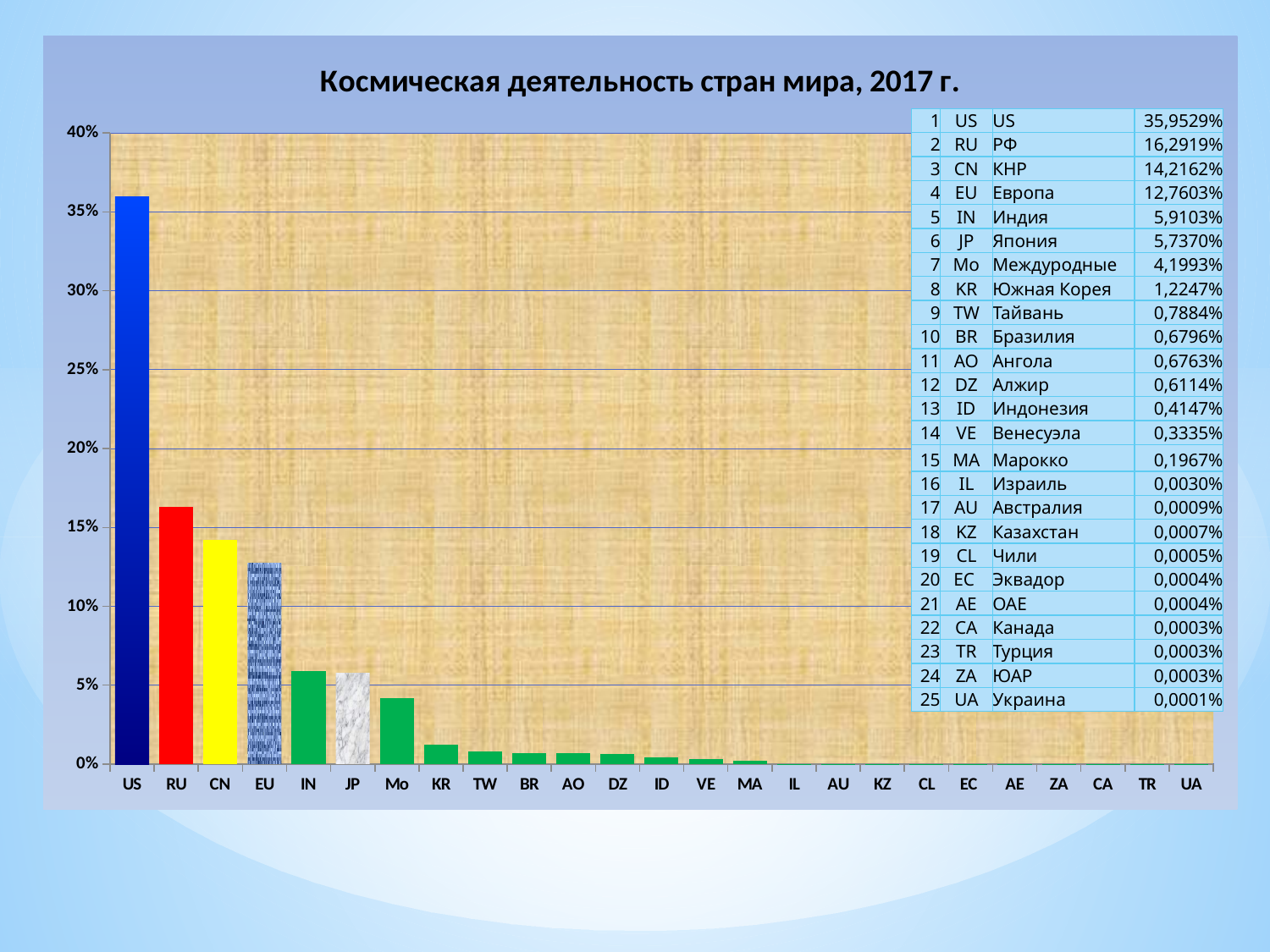
Which is larger, the value for CN or the value for EU? CN How many categories are shown on the x axis? 25 What is the value for RU? 16,2919% Do the values rise or fall from left to right along the x axis? fall Is the value for RU greater or less than 15%? greater What is the value for US? 35,9529% What is the value for KR? 1,2247% What is the value for JP? 5,7370% What kind of chart is this? bar chart Which category has the lowest value? UA Which category has the highest value? US What is the difference between the values for US and RU? 19,6610%